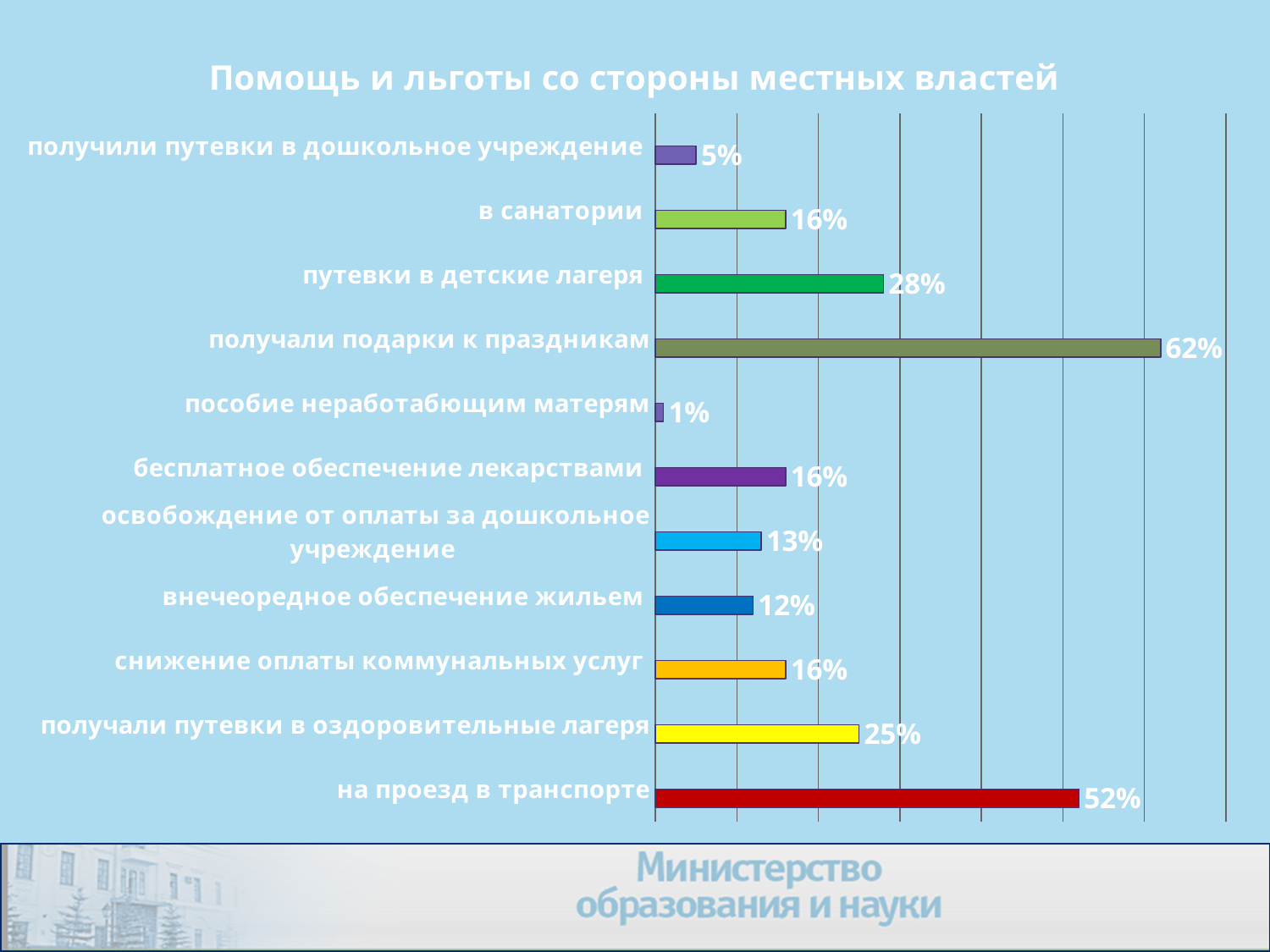
Which category has the highest value? получали подарки к праздникам How many categories are shown in the chart? 11 What is the difference between «получали подарки к праздникам» and «на проезд в транспорте»? 10% Which category has the lowest value? пособие неработабющим матерям What is the value for «на проезд в транспорте»? 52% What is the value for «получали подарки к праздникам»? 62% What is the value for «освобождение от оплаты за дошкольное учреждение»? 13% What kind of chart is shown on the slide? bar chart What is the title of the chart? Помощь и льготы со стороны местных властей What is the difference between «путевки в детские лагеря» and «получали путевки в оздоровительные лагеря»? 3% Which is larger: «внечеоредное обеспечение жильем» or «снижение оплаты коммунальных услуг»? снижение оплаты коммунальных услуг What is the value for «путевки в детские лагеря»? 28%